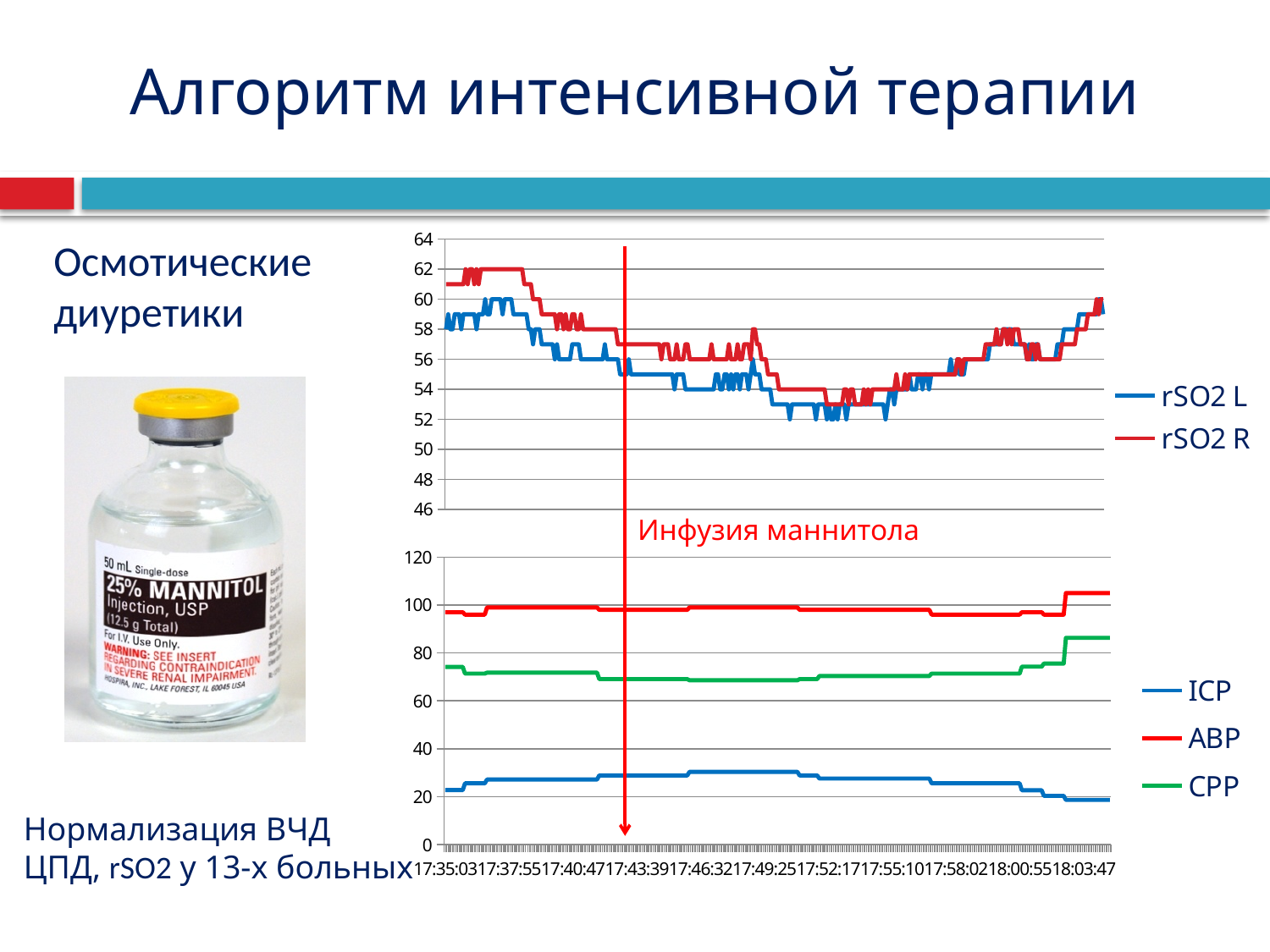
In the bottom chart, which series is plotted higher throughout: ABP or CPP? ABP In the top chart, is the lowest value of rSO2 L greater or less than 54? less In the bottom chart, is the ABP value at the end of the recording greater or less than 100? greater In the bottom chart, is the ICP value at any point greater or less than 40? less In the bottom chart, does the ICP line rise or fall over the last part of the recording (after about 17:58)? fall What event does the red vertical arrow on the chart mark? Инфузия маннитола How many series does the legend of the top chart (rSO2) list? 2 In the bottom chart, which series is plotted lower throughout: ICP or CPP? ICP How many series does the legend of the bottom chart (ICP, ABP, CPP) list? 3 What kind of chart is the top chart showing rSO2 L and rSO2 R? line chart In the top chart, at the start of the recording, which series is higher: rSO2 L or rSO2 R? rSO2 R